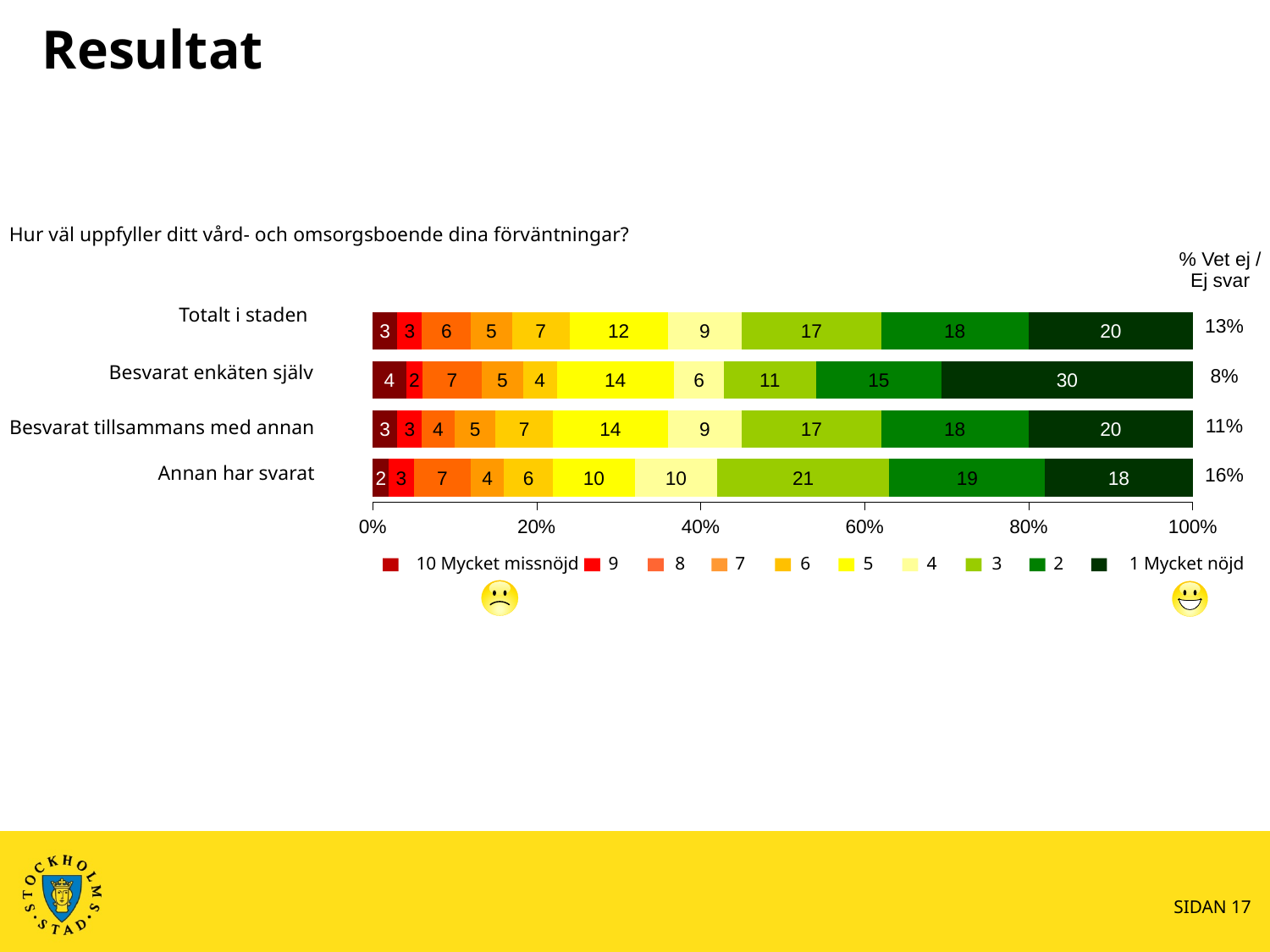
What is the total of the segments in the "Totalt i staden" bar? 100 Which category has the highest value for "1 Mycket nöjd"? Besvarat enkäten själv Which category has the highest "% Vet ej / Ej svar" value? Annan har svarat What kind of chart is shown on the slide? Stacked bar chart How many categories (bars) does the chart show? 4 What is the "% Vet ej / Ej svar" value shown for "Annan har svarat"? 16% What is the difference between the "1 Mycket nöjd" value for "Besvarat enkäten själv" and for "Totalt i staden"? 10 Which has the larger value for series "2": "Annan har svarat" or "Totalt i staden"? Annan har svarat What is the value for series "5" in the "Totalt i staden" bar? 12 How many series does the legend list? 10 What is the value for series "3" in the "Annan har svarat" bar? 21 What is the value for "1 Mycket nöjd" in the "Besvarat enkäten själv" bar? 30